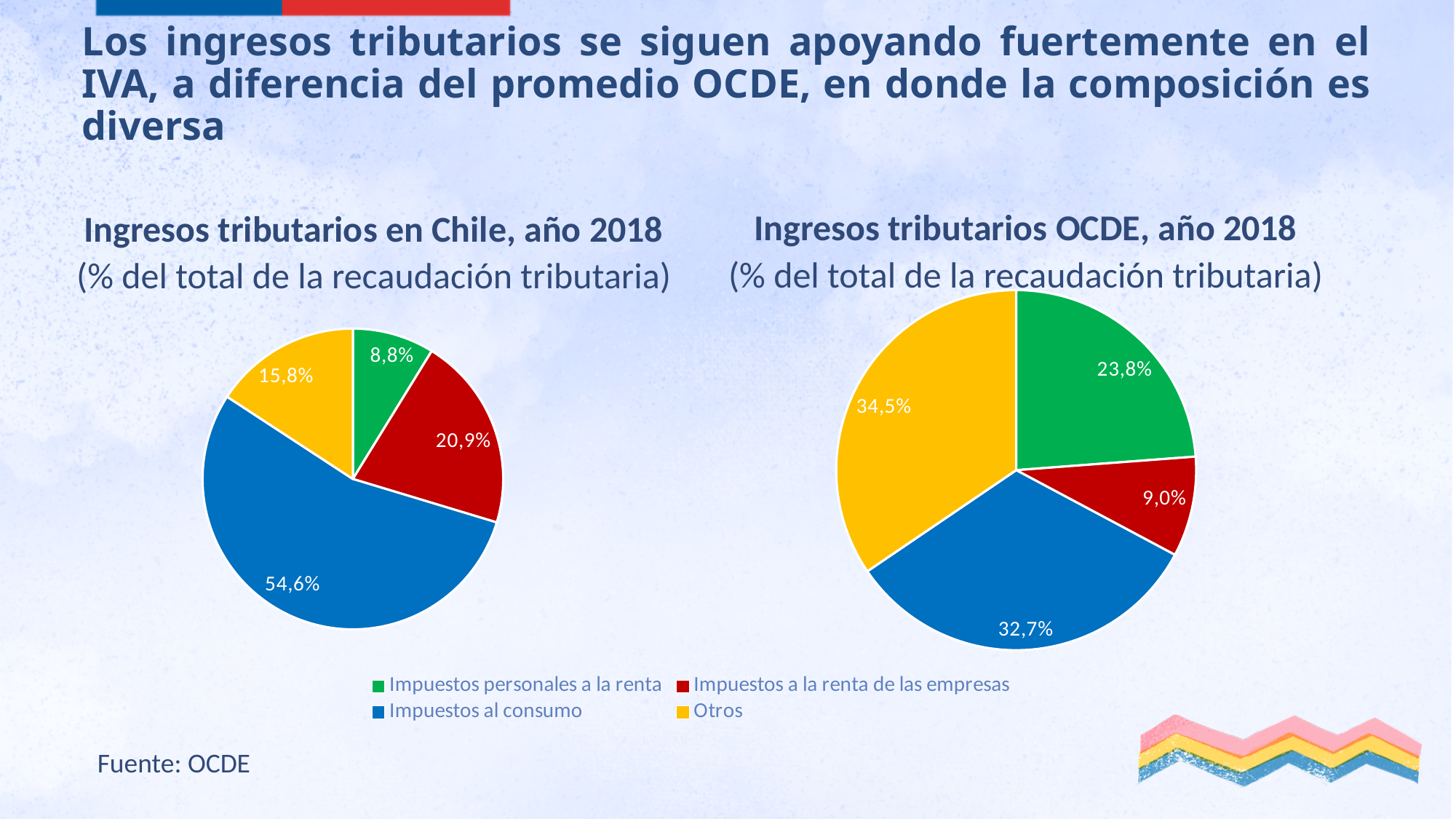
What type of chart is 'Ingresos tributarios OCDE, año 2018'? Pie chart In the chart 'Ingresos tributarios en Chile, año 2018', which category has the smallest share? Impuestos personales a la renta In the chart 'Ingresos tributarios en Chile, año 2018', what is the value for Impuestos al consumo? 54,6% In the chart 'Ingresos tributarios OCDE, año 2018', which is larger: Impuestos personales a la renta or Impuestos a la renta de las empresas? Impuestos personales a la renta In the chart 'Ingresos tributarios OCDE, año 2018', what is the value for Otros? 34,5% What is the difference between the Impuestos al consumo share in the Chile chart and in the OCDE chart? 21,9 percentage points How many slices does the chart 'Ingresos tributarios en Chile, año 2018' have? 4 In the chart 'Ingresos tributarios en Chile, año 2018', what is the value for Impuestos a la renta de las empresas? 20,9% In the chart 'Ingresos tributarios OCDE, año 2018', which category has the smallest share? Impuestos a la renta de las empresas In the chart 'Ingresos tributarios en Chile, año 2018', which category has the largest share? Impuestos al consumo Which colour represents Otros in the pie charts? Yellow In the chart 'Ingresos tributarios OCDE, año 2018', what is the value for Impuestos personales a la renta? 23,8%